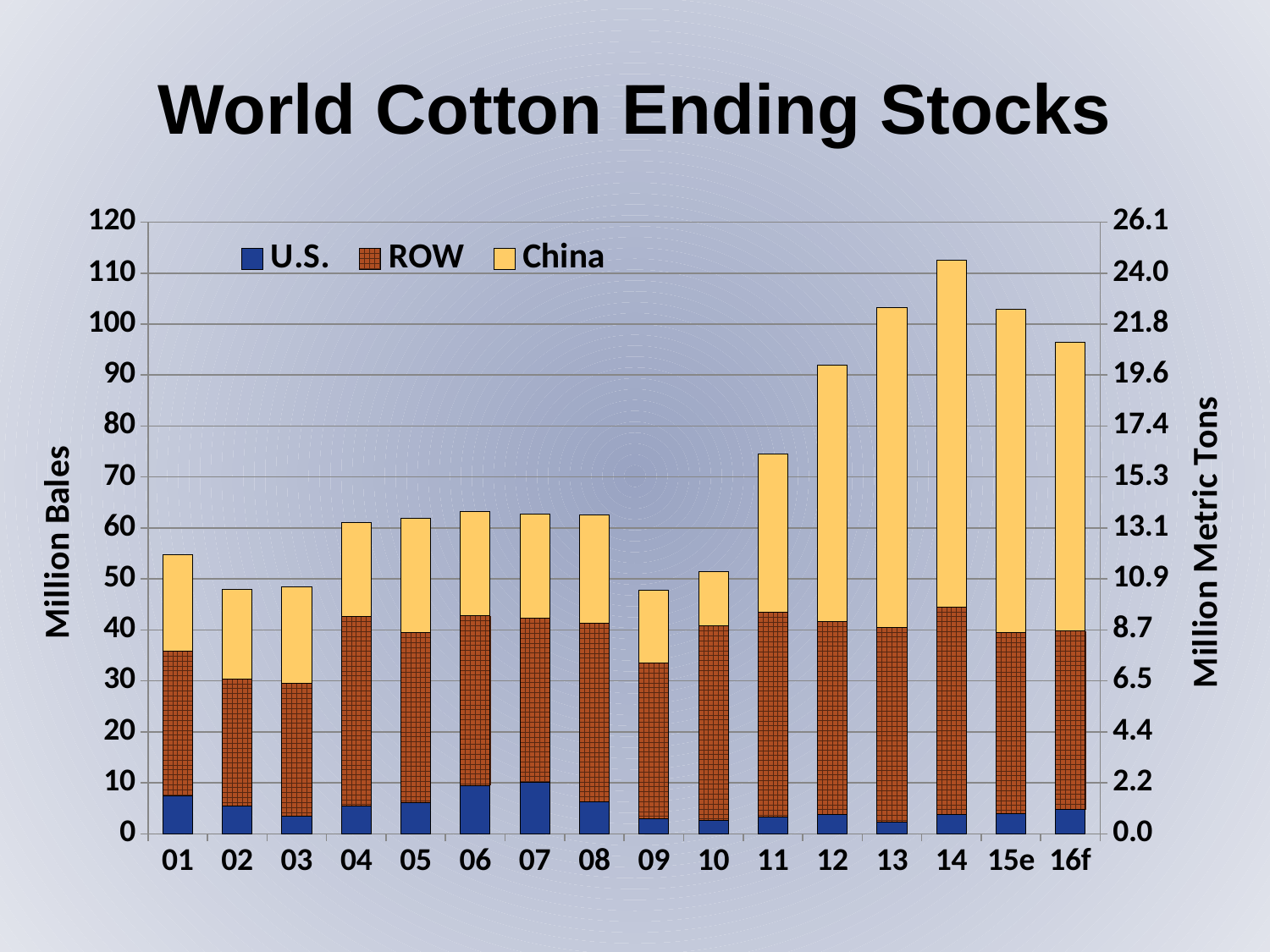
Is the total value for 16f greater or less than 90 million bales? greater Is the total value for 01 greater or less than 60 million bales? less Do total ending stocks rise or fall from 11 to 14? rise What is the label on the left vertical axis? Million Bales How many years (bars) are shown on the x axis? 16 Is the total value for 10 greater or less than 60 million bales? less How many series does the legend list? 3 Which has a larger total, 13 or 14? 14 What type of chart is shown on the slide? Stacked bar chart Which year has the highest total ending stocks? 14 Which has a larger total, 11 or 12? 12